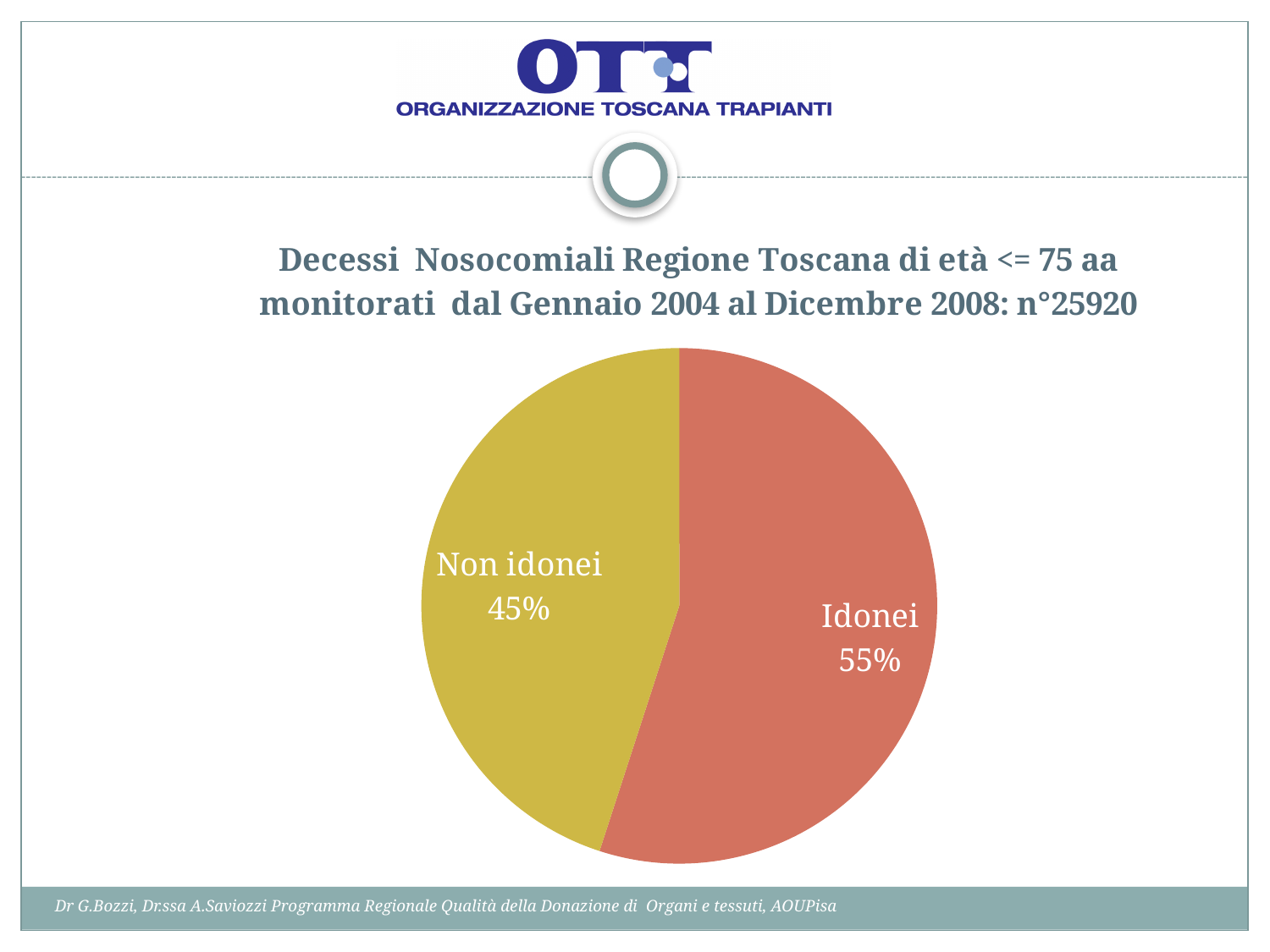
What total number of cases is stated in the chart title? n°25920 What percentage of the pie is labelled Non idonei? 45% What percentage of the pie is labelled Idonei? 55% What is the difference in percentage points between the Idonei and Non idonei slices? 10 Which slice is larger, Idonei or Non idonei? Idonei What colour is the Idonei slice of the pie? red Which slice of the pie is the smallest? Non idonei How many slices does the pie chart have? 2 What kind of chart is shown on the slide? pie chart Which slice of the pie is the largest? Idonei What share of the pie does the Non idonei slice represent? 45%